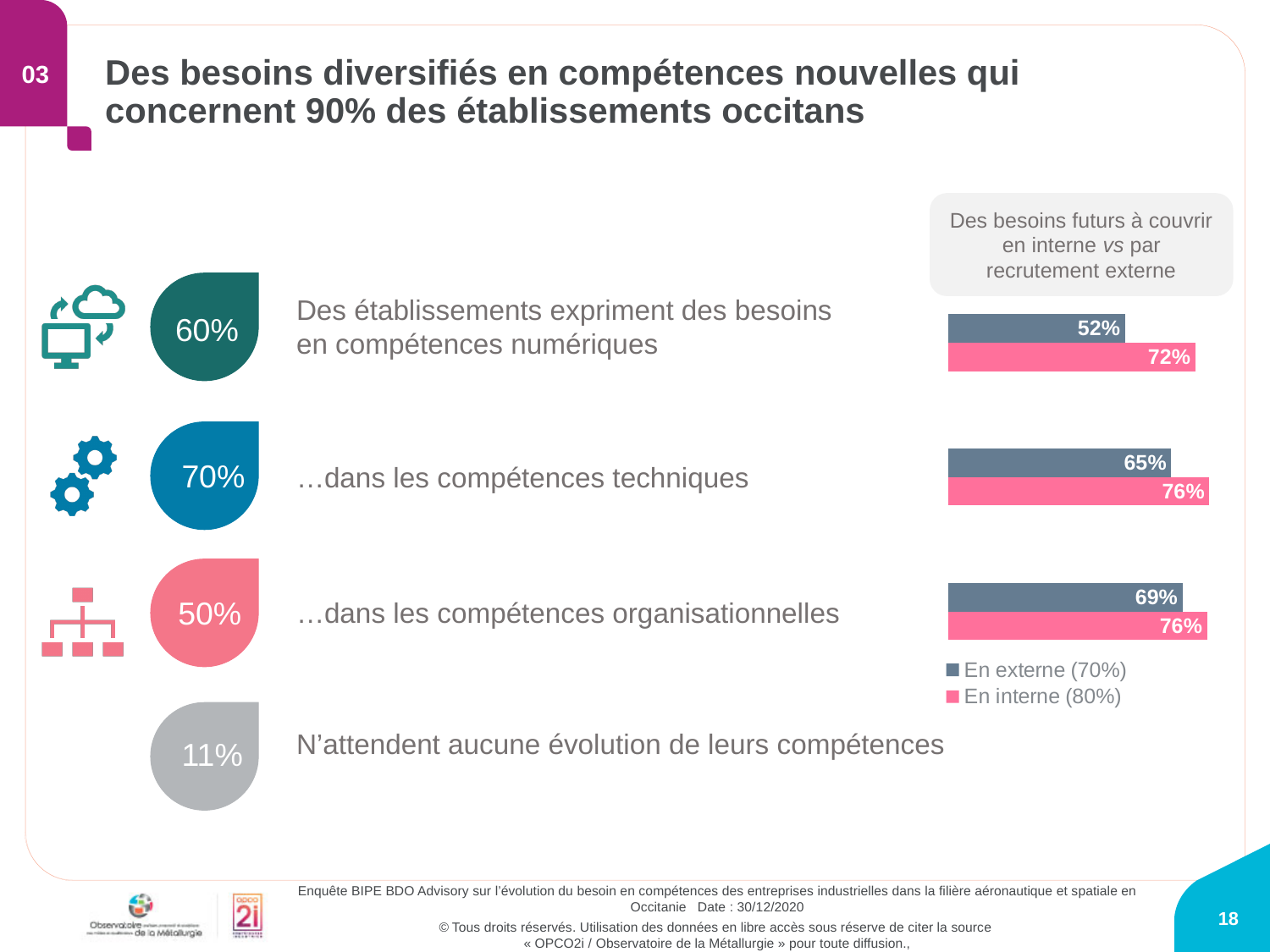
What type of chart is shown on the right of the slide? bar chart In the bar chart on the right, what is the difference between the 'En interne' and 'En externe' values for the compétences numériques row? 20% In the bar chart on the right, what is the 'En externe' value for the compétences techniques row? 65% In the bar chart on the right, for the compétences techniques row, which is larger: 'En externe' or 'En interne'? En interne In the bar chart on the right, what is the 'En interne' value for the compétences organisationnelles row? 76% In the bar chart on the right, what is the 'En externe' value for the compétences numériques row? 52% In the bar chart on the right, which row has the lowest 'En externe' value? compétences numériques In the bar chart on the right, which row has the highest 'En externe' value? compétences organisationnelles In the legend of the bar chart on the right, what percentage is shown next to 'En interne'? 80% How many series does the legend of the bar chart on the right list? 2 In the bar chart on the right, what is the difference between the 'En interne' and 'En externe' values for the compétences organisationnelles row? 7% In the bar chart on the right, what is the 'En interne' value for the compétences numériques row? 72%